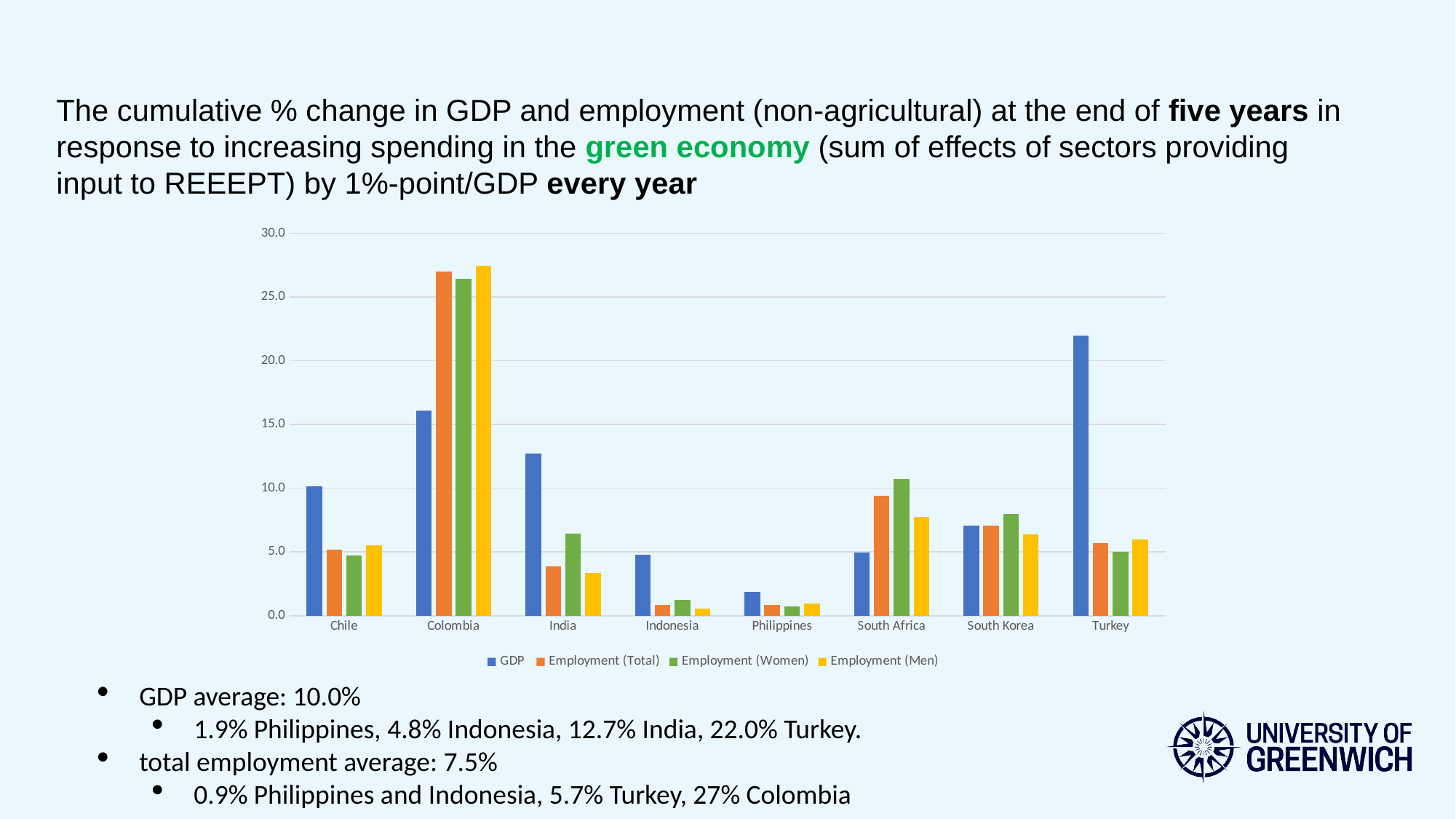
What kind of chart is shown on the slide? bar chart Is the Employment (Men) value for Colombia greater or less than 25.0? greater Is the GDP value for India greater or less than 10.0? greater How many countries are shown on the x axis of the chart? 8 Which country has the highest GDP value in the chart? Turkey According to the slide, what is the GDP value for Turkey? 22.0% Which country has the highest Employment (Total) value in the chart? Colombia Which country has the lowest GDP value in the chart? Philippines How many series does the legend list? 4 For South Africa, which is larger: the GDP bar or the Employment (Women) bar? Employment (Women) What are the four series listed in the chart legend? GDP, Employment (Total), Employment (Women), Employment (Men) Is the Employment (Men) value for Indonesia greater or less than 5.0? less